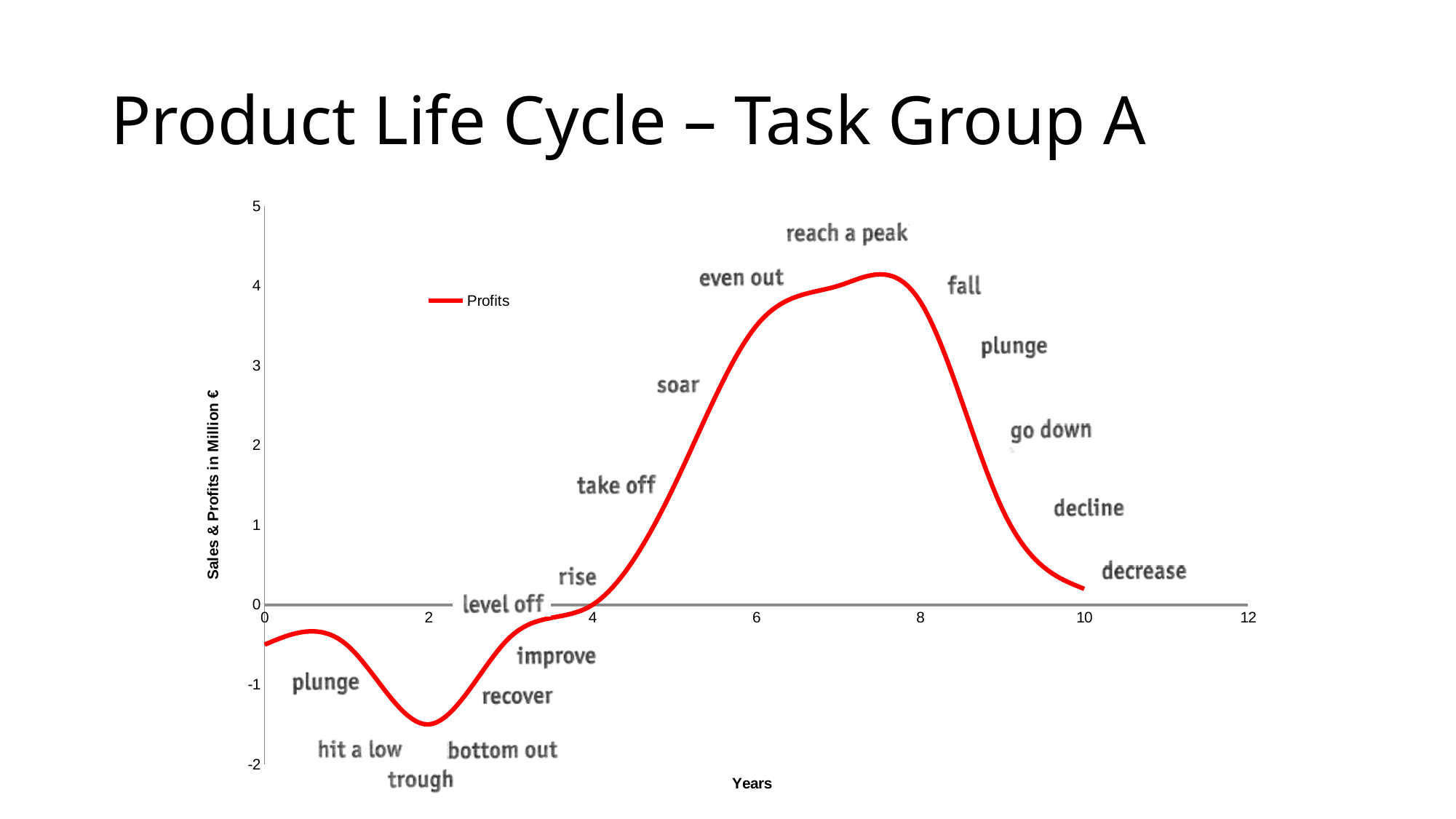
Do Profits rise or fall between year 8 and year 10? fall Is the Profits value at year 10 greater or less than 1? less What is the name of the series shown in the chart's legend? Profits Is the Profits value at year 6 greater or less than 3? greater What kind of chart is shown on the slide? line chart Is the Profits value at year 2 greater or less than -1? less How many series does the chart's legend list? 1 Which is larger, the Profits value at year 6 or at year 2? year 6 What is the title of the vertical axis of the chart? Sales & Profits in Million € Do Profits rise or fall between year 4 and year 6? rise